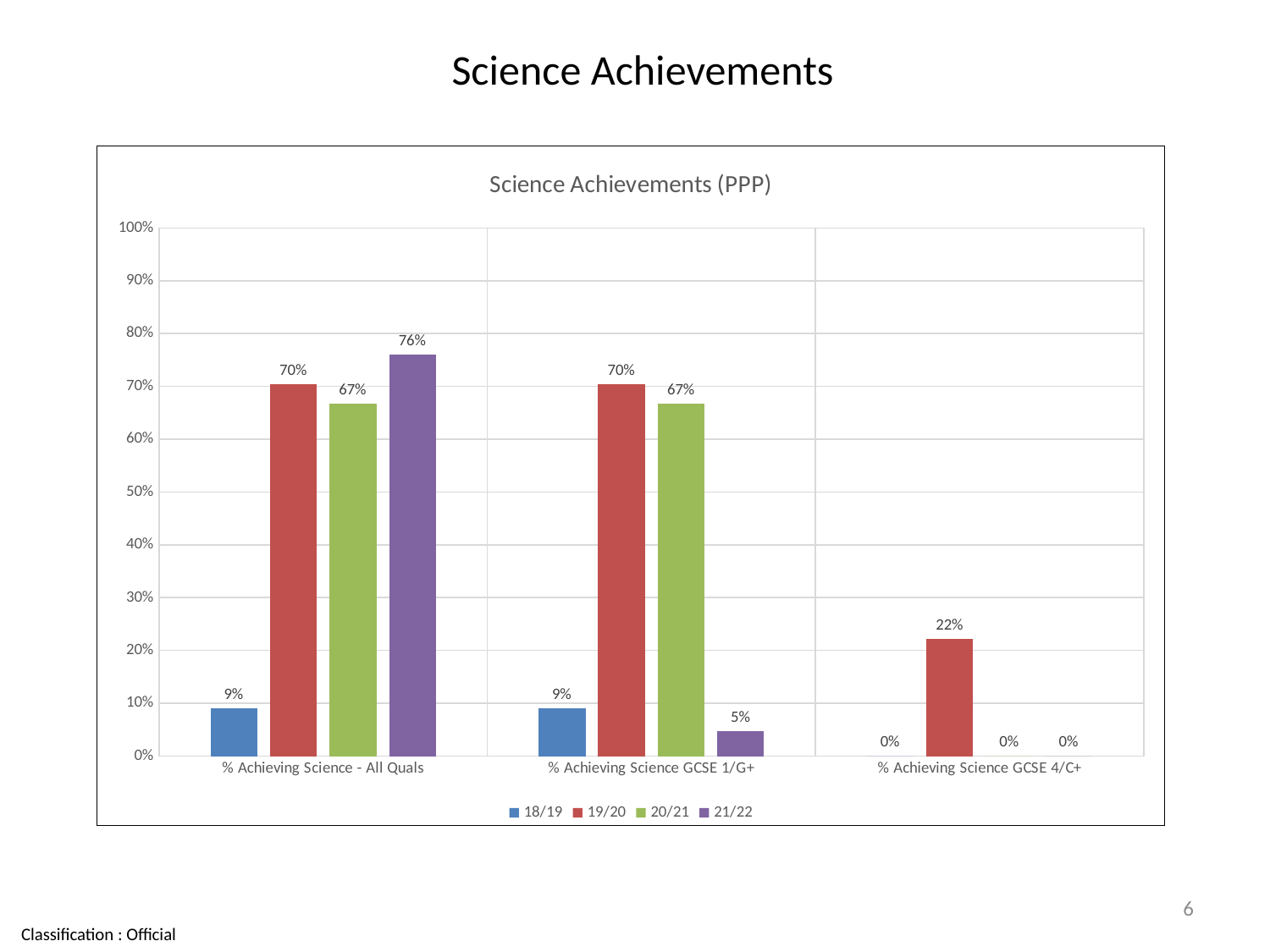
How many categories are shown on the x axis? 3 Which series has the lowest value in the '% Achieving Science GCSE 1/G+' category? 21/22 What is the title of the chart? Science Achievements (PPP) What kind of chart is shown on the slide? Bar chart What is the difference between the 19/20 and 20/21 values in the '% Achieving Science GCSE 1/G+' category? 3% How many series does the legend list? 4 What is the difference between the 21/22 and 18/19 values in the '% Achieving Science - All Quals' category? 67% Which is larger: the 19/20 value or the 20/21 value in the '% Achieving Science - All Quals' category? 19/20 What is the value for 19/20 in the '% Achieving Science GCSE 4/C+' category? 22% What is the value for 21/22 in the '% Achieving Science - All Quals' category? 76% What is the value for 21/22 in the '% Achieving Science GCSE 1/G+' category? 5% Which series has the highest value in the '% Achieving Science - All Quals' category? 21/22